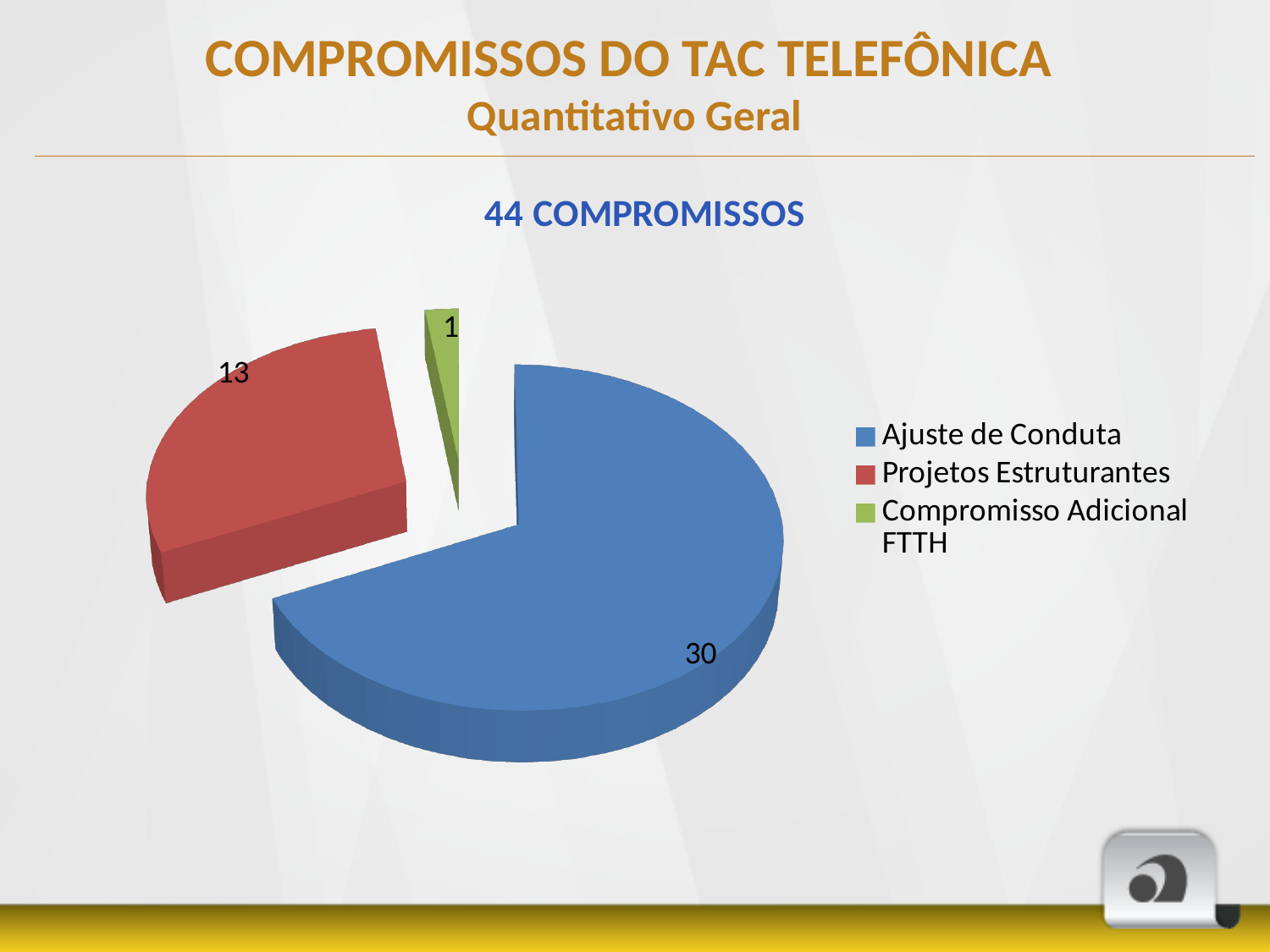
How many categories does the pie chart have? 3 Which category has the largest slice of the pie? Ajuste de Conduta What colour is the slice for Projetos Estruturantes? Red What is the difference between the values for Ajuste de Conduta and Projetos Estruturantes? 17 What share of the total does Ajuste de Conduta represent? 30 out of 44 What is the total of all slices in the pie chart? 44 What type of chart is shown on the slide? Pie chart What is the value for Compromisso Adicional FTTH? 1 Which category has the smallest slice of the pie? Compromisso Adicional FTTH What is the value for Projetos Estruturantes? 13 Which is larger, Projetos Estruturantes or Compromisso Adicional FTTH? Projetos Estruturantes What is the value for Ajuste de Conduta? 30